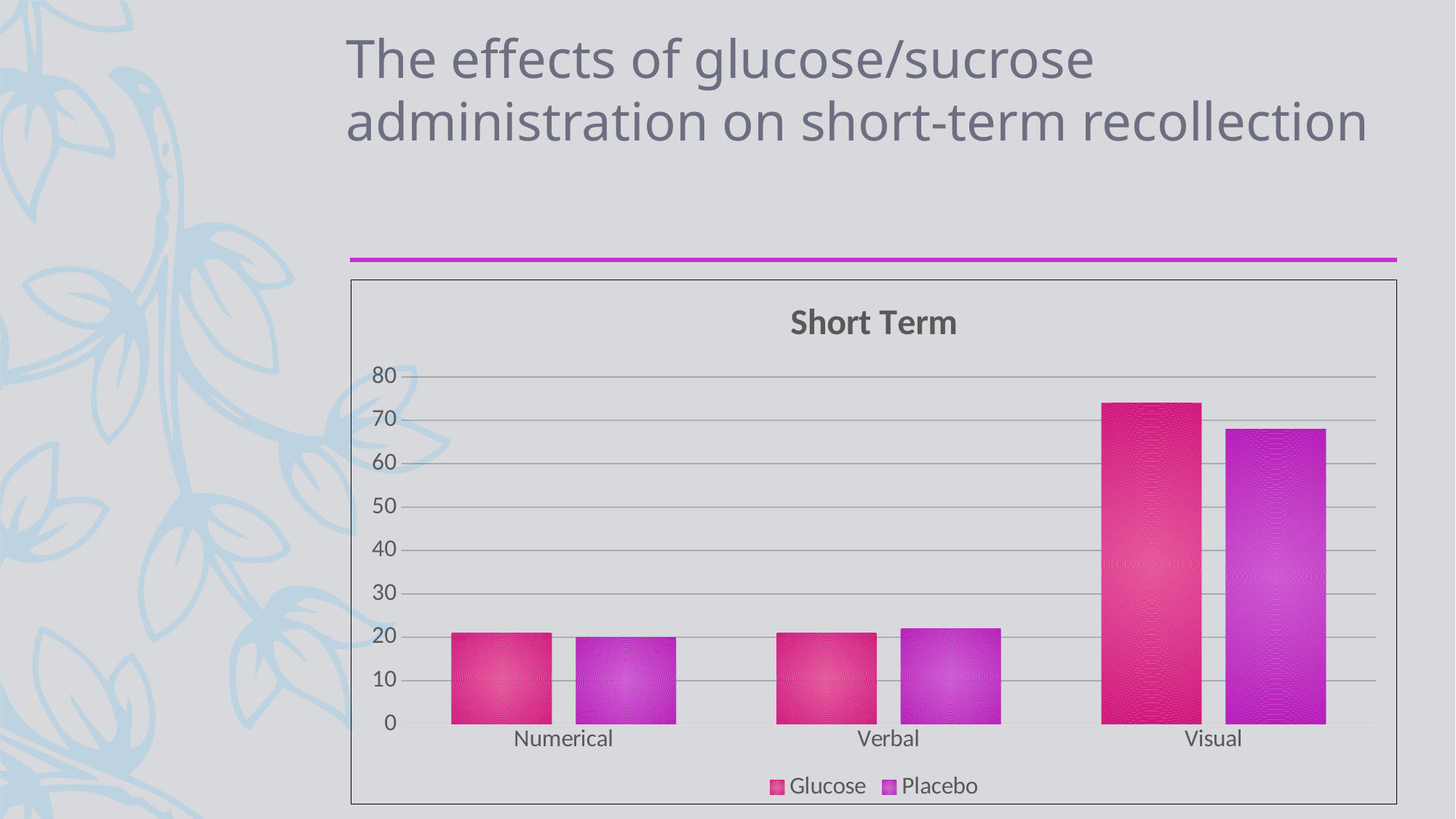
Which series is shown in the pink bars according to the legend? Glucose Which category has the highest Placebo value? Visual Is the Placebo value for Visual greater or less than 60? greater What kind of chart is shown on the slide? bar chart Is the Placebo value for Visual greater or less than 70? less Is the Glucose value for Visual greater or less than 70? greater How many series does the legend list? 2 For the Visual category, which is larger, Glucose or Placebo? Glucose What is the title of the chart? Short Term How many categories are shown on the x axis? 3 Which category has the highest Glucose value? Visual